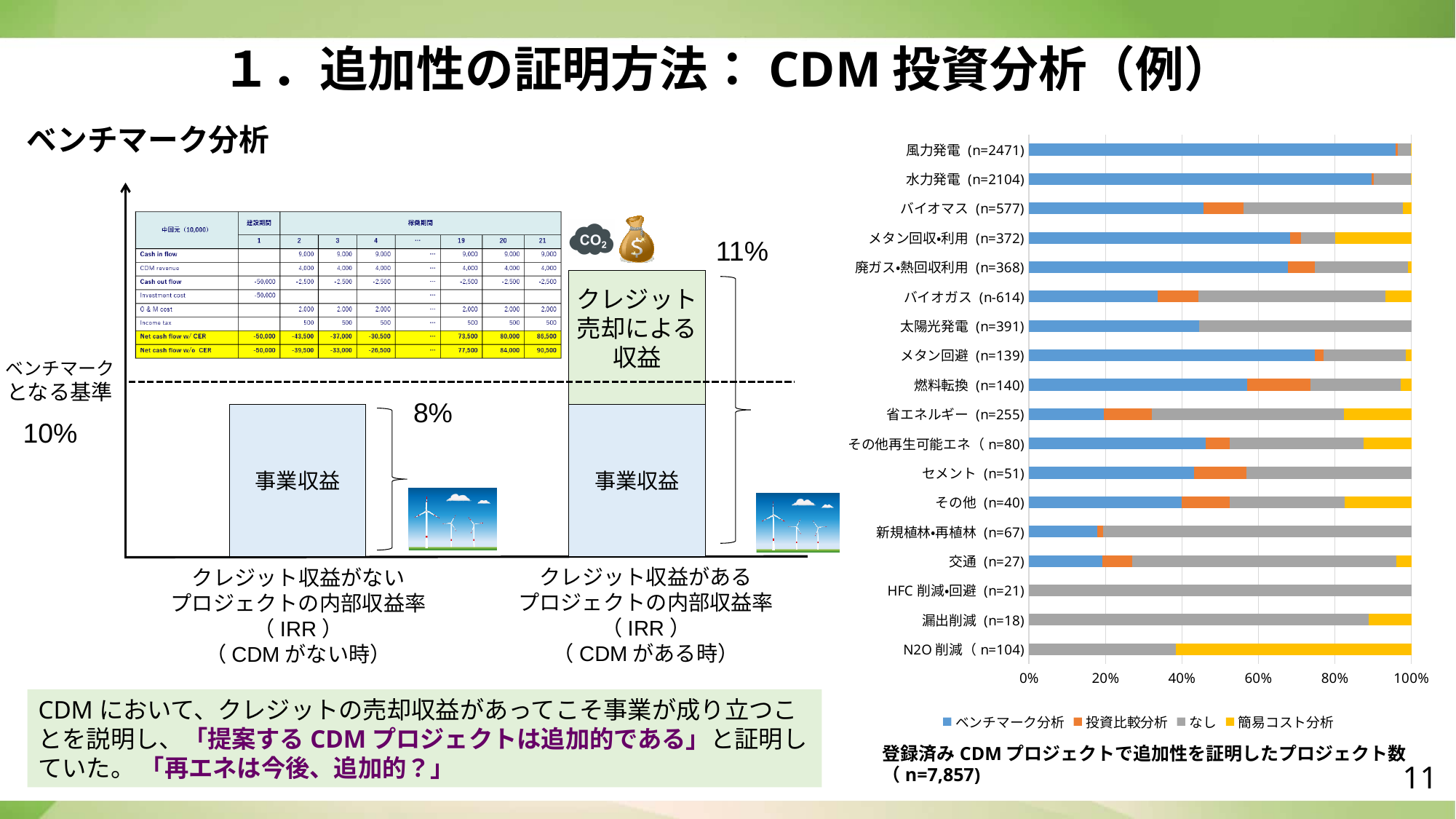
In the right-hand chart, which has the larger ベンチマーク分析 share: 太陽光発電 (n=391) or 省エネルギー (n=255)? 太陽光発電 (n=391) What is the sample size n shown for 水力発電 in the right-hand chart? 2104 In the right-hand chart, which category has the largest ベンチマーク分析 share? 風力発電 (n=2471) In the right-hand chart, which has the larger 投資比較分析 share: 燃料転換 (n=140) or 風力発電 (n=2471)? 燃料転換 (n=140) What kind of chart is shown on the right side of the slide? Stacked bar chart In the right-hand chart, is the 簡易コスト分析 share for N2O削減 (n=104) greater or less than 40%? greater In the right-hand chart, is the ベンチマーク分析 share for 省エネルギー (n=255) greater or less than 40%? less How many project categories are plotted in the right-hand chart? 18 In the right-hand chart, is the ベンチマーク分析 share for 風力発電 (n=2471) greater or less than 80%? greater What is the title printed below the right-hand chart? 登録済みCDMプロジェクトで追加性を証明したプロジェクト数（n=7,857） How many series does the legend of the right-hand chart list? 4